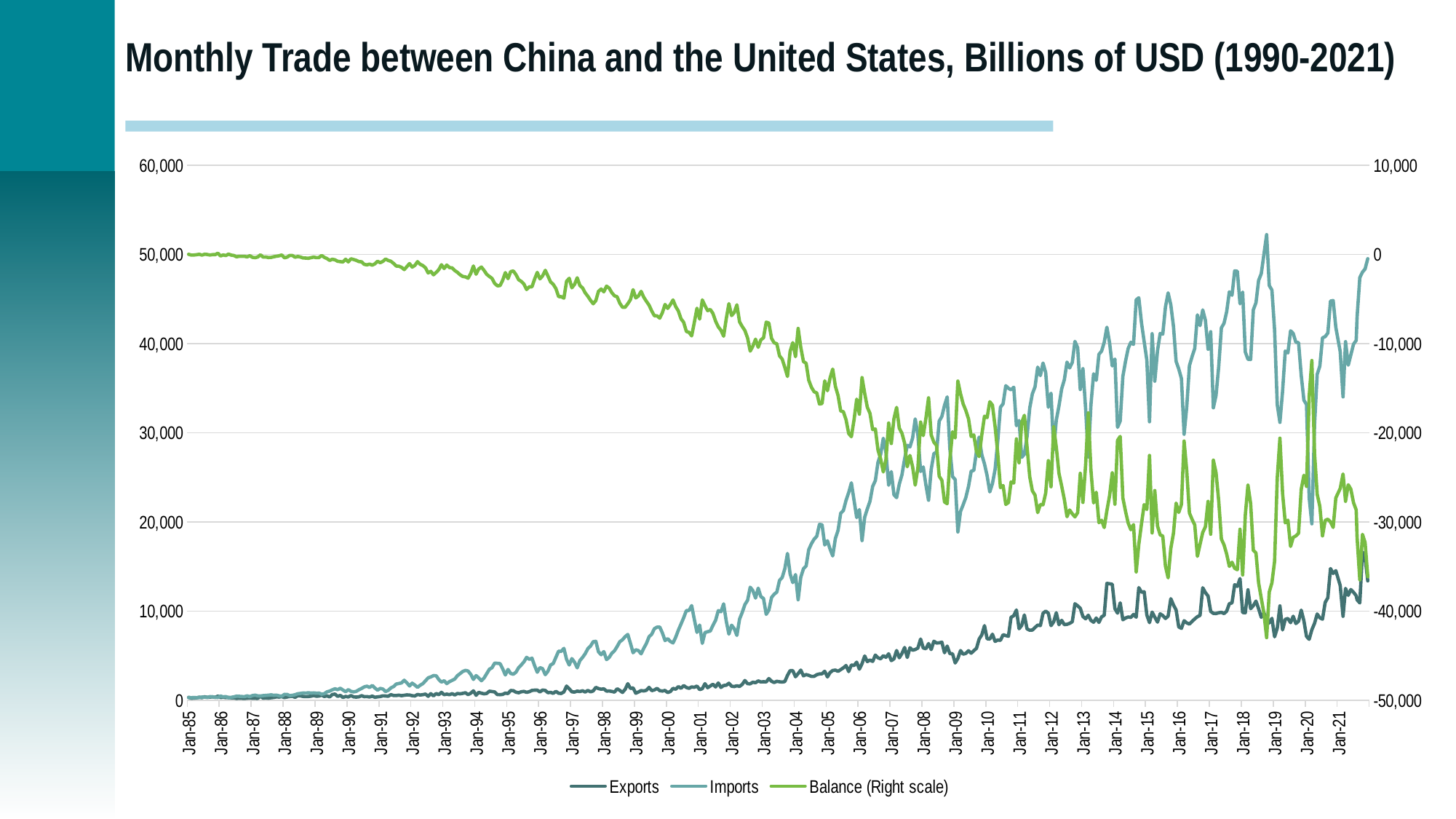
What kind of chart is shown on the slide? line chart Do the Exports values generally rise or fall from Jan-85 to Jan-21? rise Is the value for Imports at Jan-99 greater or less than 10,000? less Does the Balance series generally rise or fall from Jan-85 to Jan-21? fall What is the title of the chart? Monthly Trade between China and the United States, Billions of USD (1990-2021) Is the value for Imports at Jan-05 greater or less than 30,000? less Is the value for Imports at Jan-18 greater or less than 40,000? greater At Jan-15, which is larger, Imports or Exports? Imports Which series is plotted on the right scale? Balance How many series does the legend list? 3